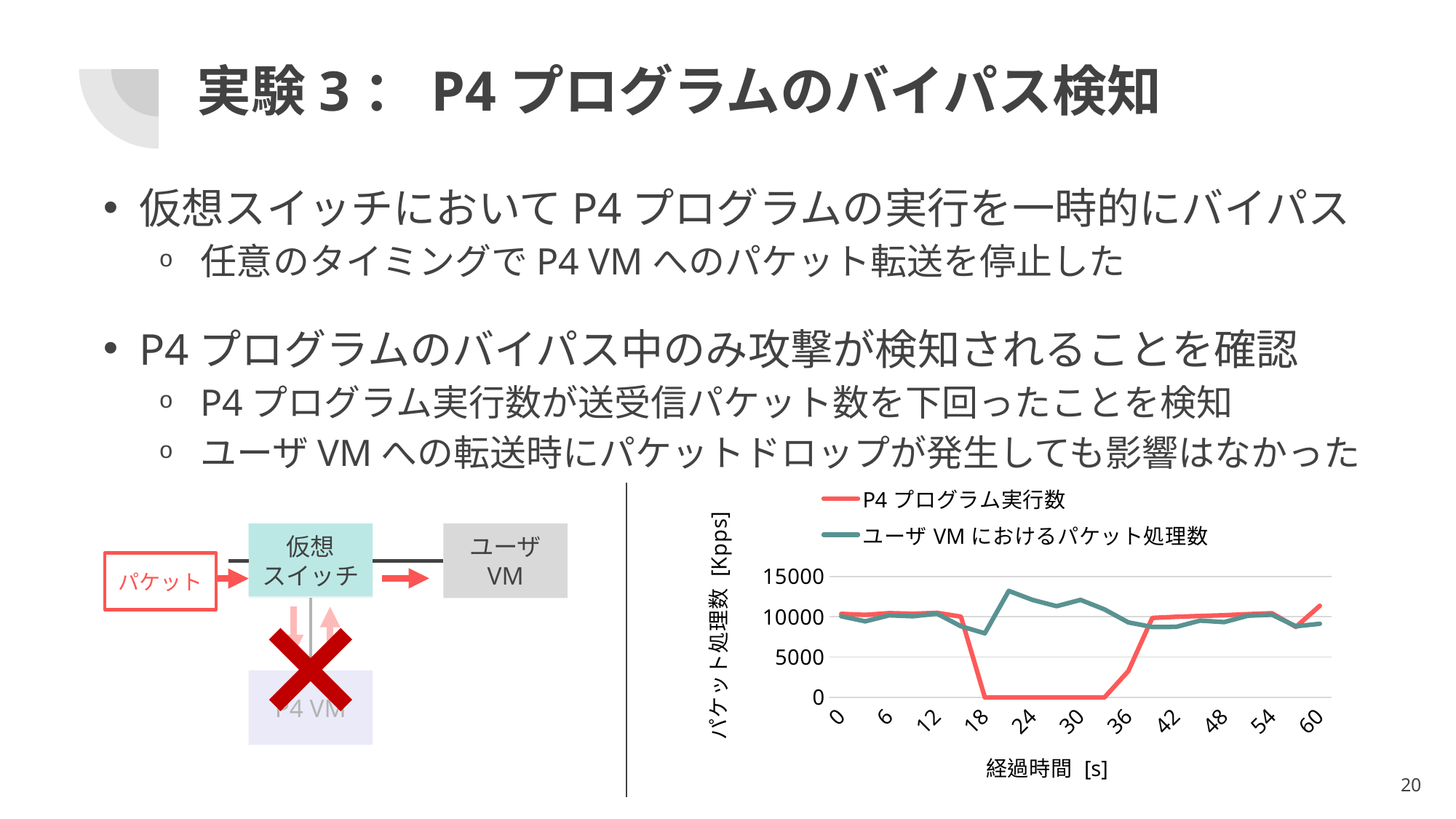
Is the value of P4 プログラム実行数 at 24 s greater or less than 5000? less How many tick labels are shown on the x axis of the chart? 11 Does the P4 プログラム実行数 series rise or fall between 36 s and 42 s? rise Does the P4 プログラム実行数 series rise or fall between 12 s and 18 s? fall Is the value of ユーザ VM におけるパケット処理数 at 24 s greater or less than 10000? greater What kind of chart is shown on the slide? line chart How many series does the chart legend list? 2 What is the label of the chart's y axis? パケット処理数 [Kpps] Is the value of ユーザ VM におけるパケット処理数 at 18 s greater or less than 10000? less What are the two series named in the chart legend? P4 プログラム実行数 and ユーザ VM におけるパケット処理数 At 24 s, which series has the higher value, P4 プログラム実行数 or ユーザ VM におけるパケット処理数? ユーザ VM におけるパケット処理数